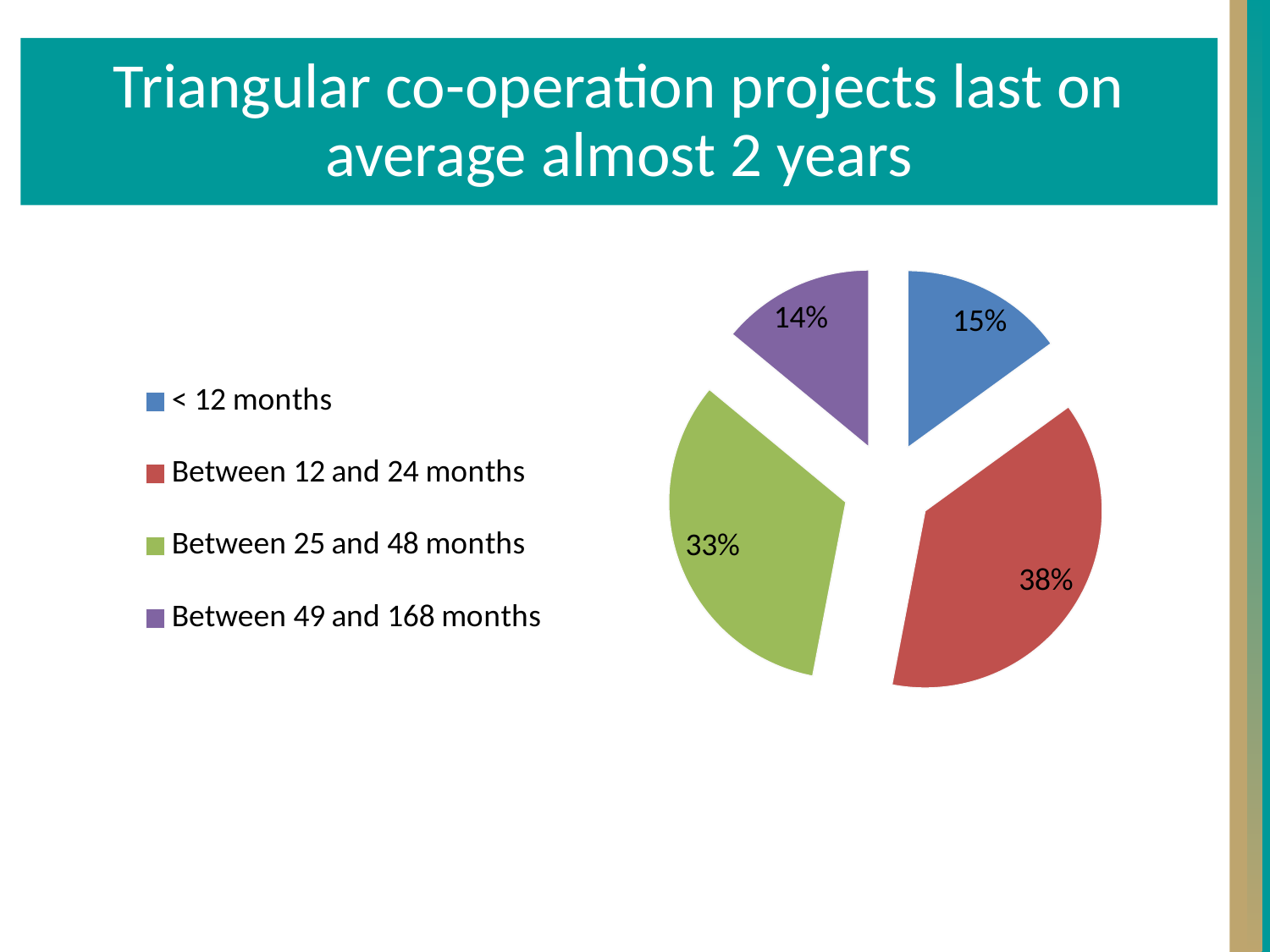
Which is larger: the share for '< 12 months' or the share for 'Between 25 and 48 months'? Between 25 and 48 months Which duration category has the smallest share of the pie? Between 49 and 168 months What colour is the slice for 'Between 25 and 48 months'? green What is the combined share of projects lasting 24 months or less? 53% Which duration category has the largest share of the pie? Between 12 and 24 months What share of projects last less than 12 months? 15% What share of projects last between 25 and 48 months? 33% What share of projects last between 49 and 168 months? 14% What is the difference in percentage points between the 'Between 12 and 24 months' slice and the 'Between 25 and 48 months' slice? 5 percentage points What share of projects last between 12 and 24 months? 38% What kind of chart is shown on the slide? pie chart How many slices does the pie chart have? 4